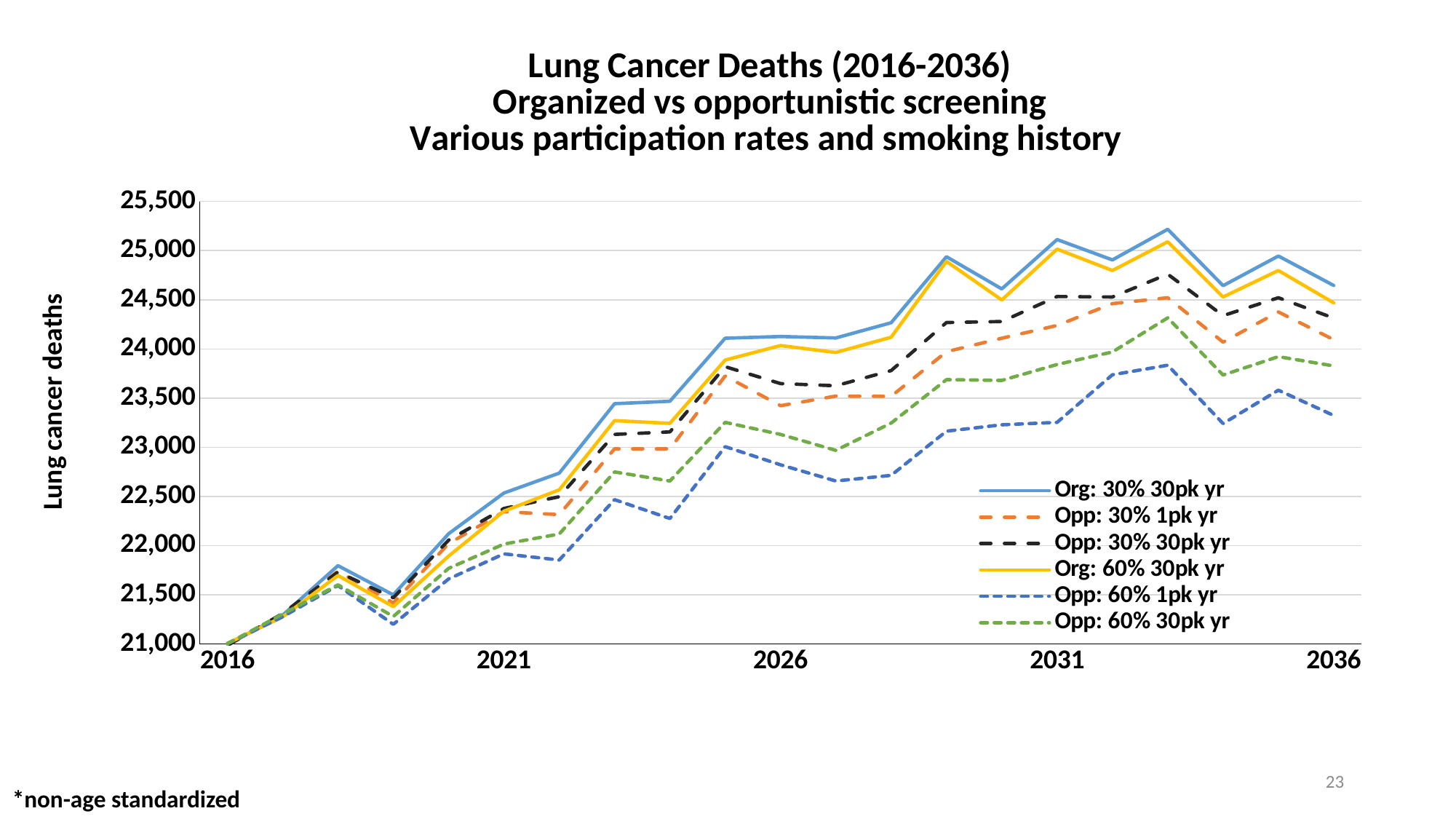
Is the value for Opp: 60% 1pk yr in 2036 greater or less than 23,500? less In 2036, which is larger: Org: 30% 30pk yr or Opp: 60% 1pk yr? Org: 30% 30pk yr How many series does the legend list? 6 Which series has the highest value in 2036? Org: 30% 30pk yr What kind of chart is shown on the slide? line chart Is the value for Org: 30% 30pk yr in 2036 greater or less than 24,000? greater Is the value for Opp: 60% 1pk yr in 2026 greater or less than 23,000? less What is the label of the y axis? Lung cancer deaths Do the lung cancer deaths for Org: 30% 30pk yr generally rise or fall from 2016 to 2036? rise Which series has the lowest value in 2036? Opp: 60% 1pk yr How many year labels are shown on the x axis? 5